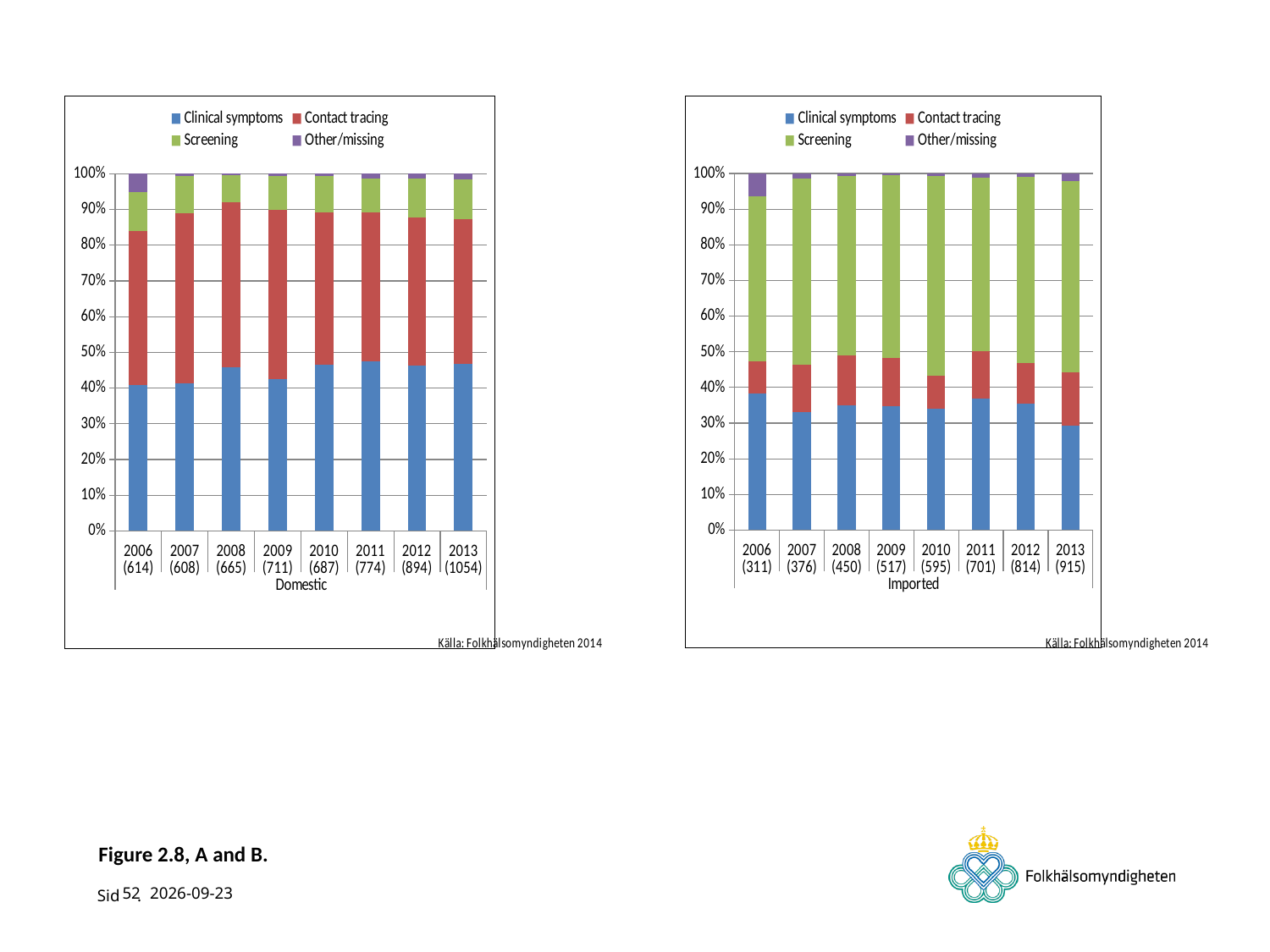
In the Domestic chart, which year has the larger Clinical symptoms share, 2006 or 2008? 2008 In the Imported chart, is the Clinical symptoms share for 2006 greater or less than 30%? greater In the Imported chart, which year has the lowest Clinical symptoms share? 2013 In the Imported chart, is the Clinical symptoms share for 2013 greater or less than 40%? less In the Imported chart, which year has the larger Clinical symptoms share, 2006 or 2013? 2006 What group label appears below the years on the x axis of the right-hand chart? Imported What kind of chart is the Domestic chart on the left? Stacked bar chart In the Domestic chart, is the Clinical symptoms share for 2006 greater or less than 50%? less What number appears in parentheses under 2013 in the Domestic chart? 1054 How many series does the legend of the Imported chart list? 4 How many years are shown on the x axis of the Domestic chart? 8